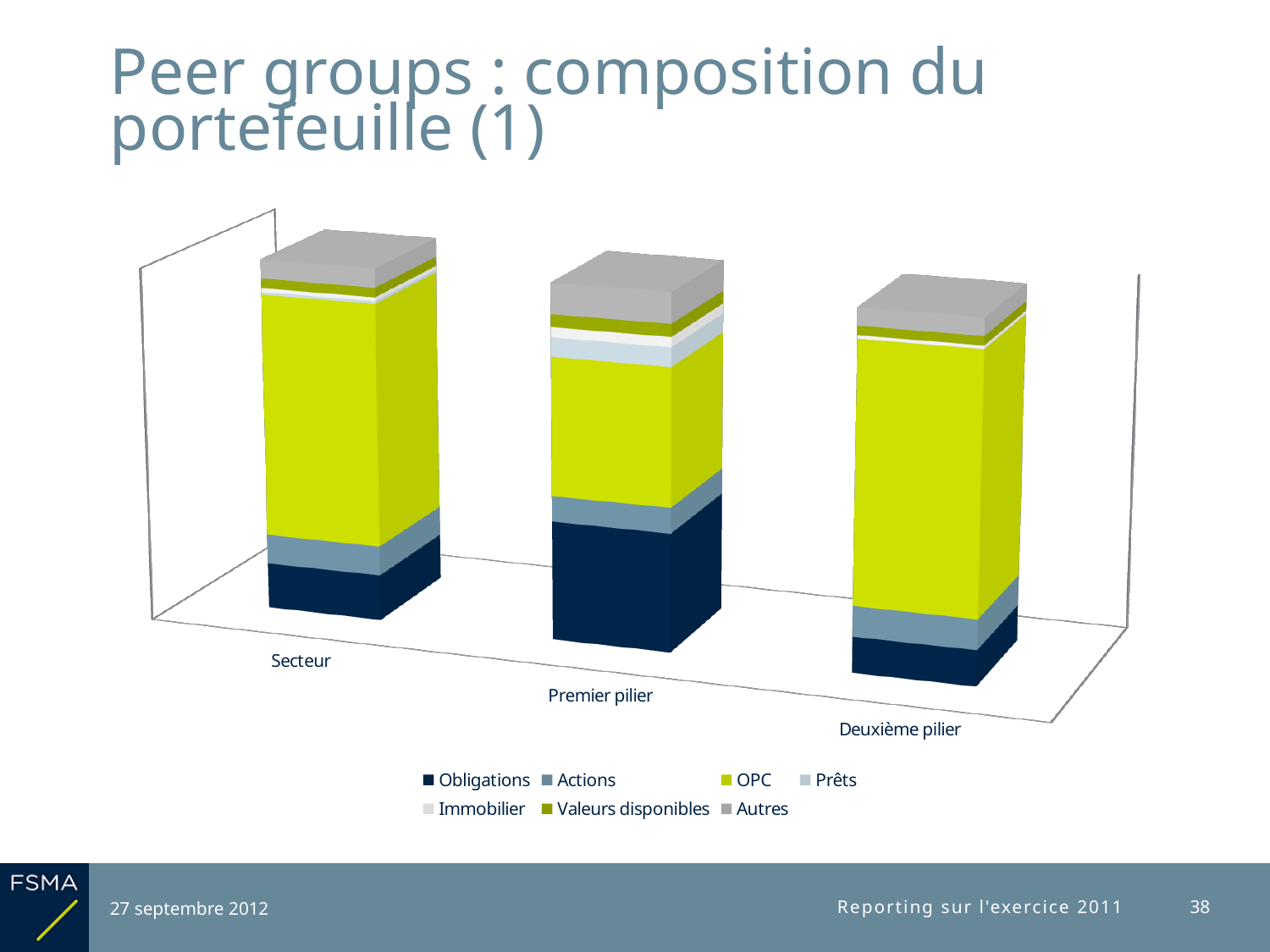
Which category has the smallest OPC segment? Premier pilier Is the OPC segment larger for Secteur or for Premier pilier? Secteur How many series does the chart legend list? 7 How many categories are shown along the x axis of the chart? 3 Which category has the largest Immobilier segment? Premier pilier What kind of chart is shown on the slide? Stacked bar chart Which series is shown in dark navy blue at the bottom of each stacked bar? Obligations Which series makes up the largest part of the Secteur bar? OPC Is the Obligations segment larger for Premier pilier or for Deuxième pilier? Premier pilier Which category has the largest Obligations segment? Premier pilier What are the three categories shown on the x axis of the chart? Secteur, Premier pilier, Deuxième pilier